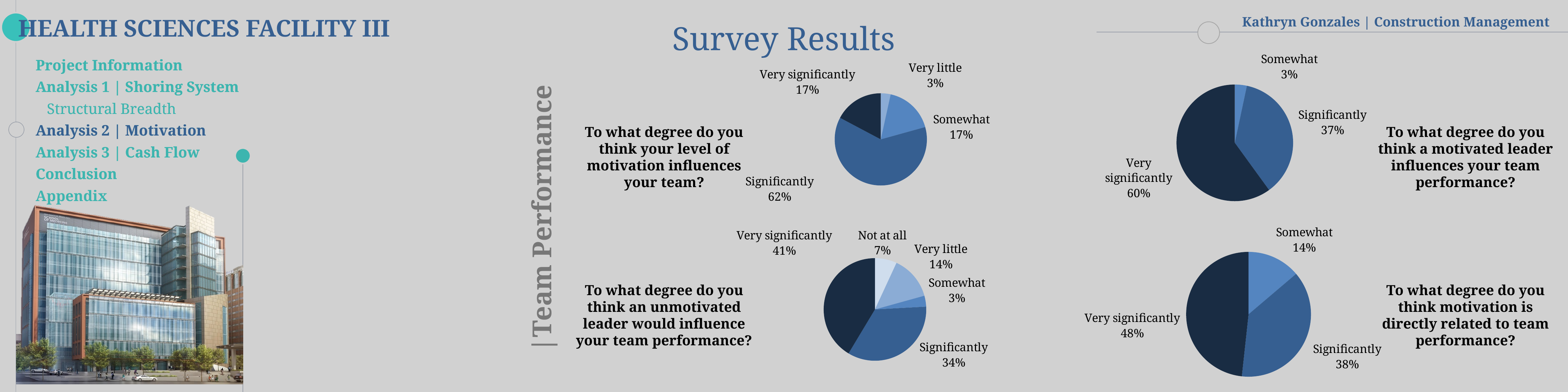
How many response categories are shown in the pie chart for "To what degree do you think an unmotivated leader would influence your team performance?"? 5 In the pie chart for "To what degree do you think an unmotivated leader would influence your team performance?", which response has the smallest share? Somewhat In the pie chart for "To what degree do you think a motivated leader influences your team performance?", what is the difference between the "Very significantly" and "Significantly" shares? 23% In the pie chart for "To what degree do you think your level of motivation influences your team?", what share answered "Very little"? 3% In the pie chart for "To what degree do you think a motivated leader influences your team performance?", which response has the largest share? Very significantly In the pie chart for "To what degree do you think motivation is directly related to team performance?", what is the difference between the "Very significantly" and "Significantly" shares? 10% What type of chart is used to show the survey results on this slide? Pie chart In the pie chart for "To what degree do you think an unmotivated leader would influence your team performance?", what share answered "Not at all"? 7% In the pie chart for "To what degree do you think motivation is directly related to team performance?", what share answered "Somewhat"? 14% In the pie chart for "To what degree do you think your level of motivation influences your team?", what share of respondents answered "Significantly"? 62% In the pie chart for "To what degree do you think an unmotivated leader would influence your team performance?", which is larger: "Very significantly" or "Significantly"? Very significantly How many pie charts are shown on the slide? 4